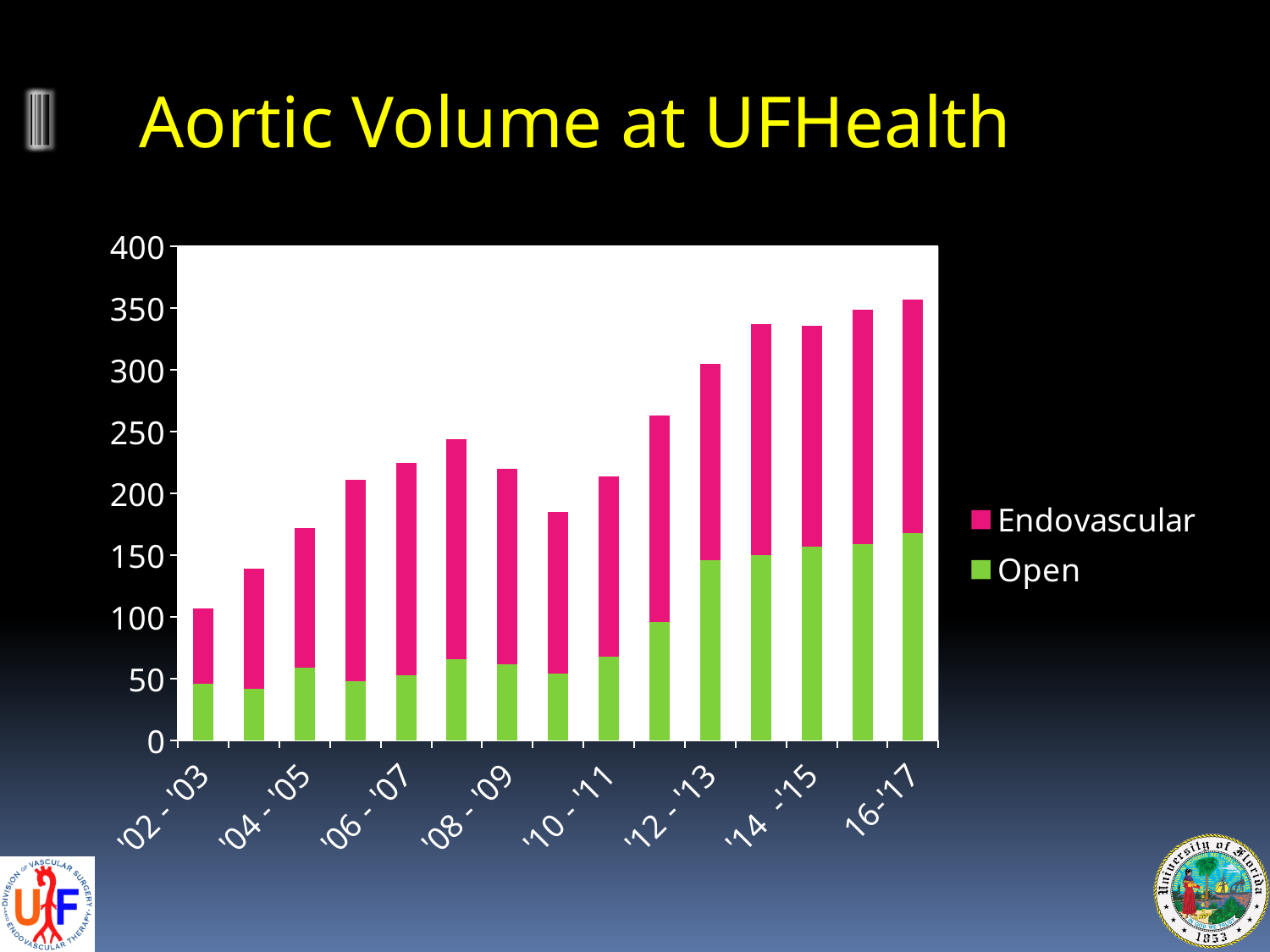
Which period has the larger total bar, '10 - '11 or '12 - '13? '12 - '13 How many bars are plotted in the chart? 15 Which series is shown in green? Open Do the total bar heights generally rise or fall from '02 - '03 to '16-'17? rise Is the Open value for '16-'17 greater or less than 150? greater How many series does the legend list? 2 Is the total bar for '02 - '03 greater or less than 150? less Which period has the tallest total bar? '16-'17 Which period has the shortest total bar? '02 - '03 Is the total bar for '16-'17 greater or less than 300? greater What is the title of the chart? Aortic Volume at UFHealth What type of chart is shown on the slide? Stacked bar chart